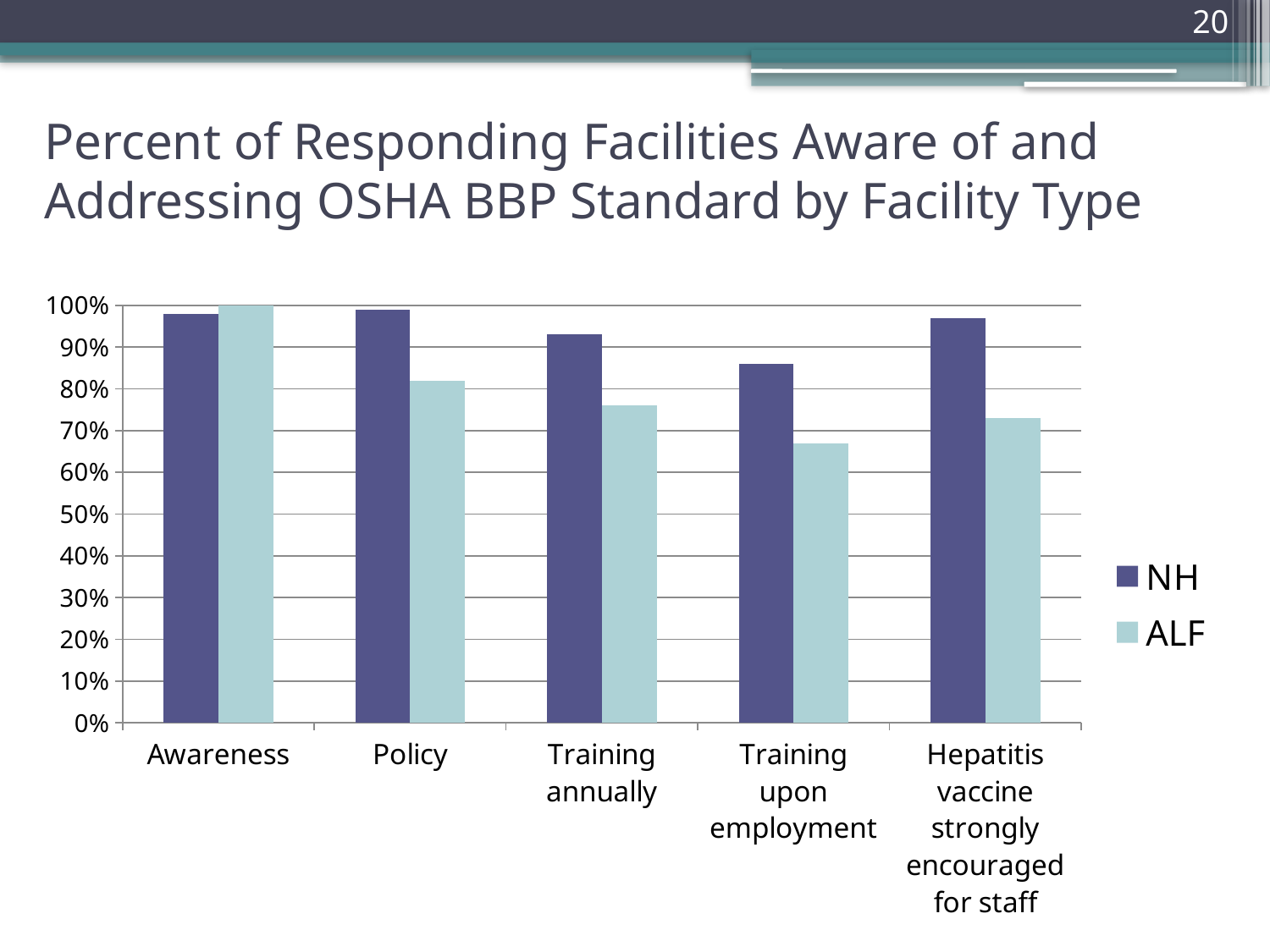
For which category is the NH value lowest? Training upon employment Is the ALF value for Policy greater or less than 80%? greater Which series has the larger value for Policy, NH or ALF? NH Is the ALF value for Training upon employment greater or less than 70%? less Which series has the larger value for Awareness, NH or ALF? ALF How many categories are shown on the x axis? 5 Is the NH value for Training annually greater or less than 90%? greater How many series does the legend list? 2 What are the two series named in the legend? NH and ALF What kind of chart is shown on the slide? bar chart For which category is the ALF value highest? Awareness For which category is the ALF value lowest? Training upon employment